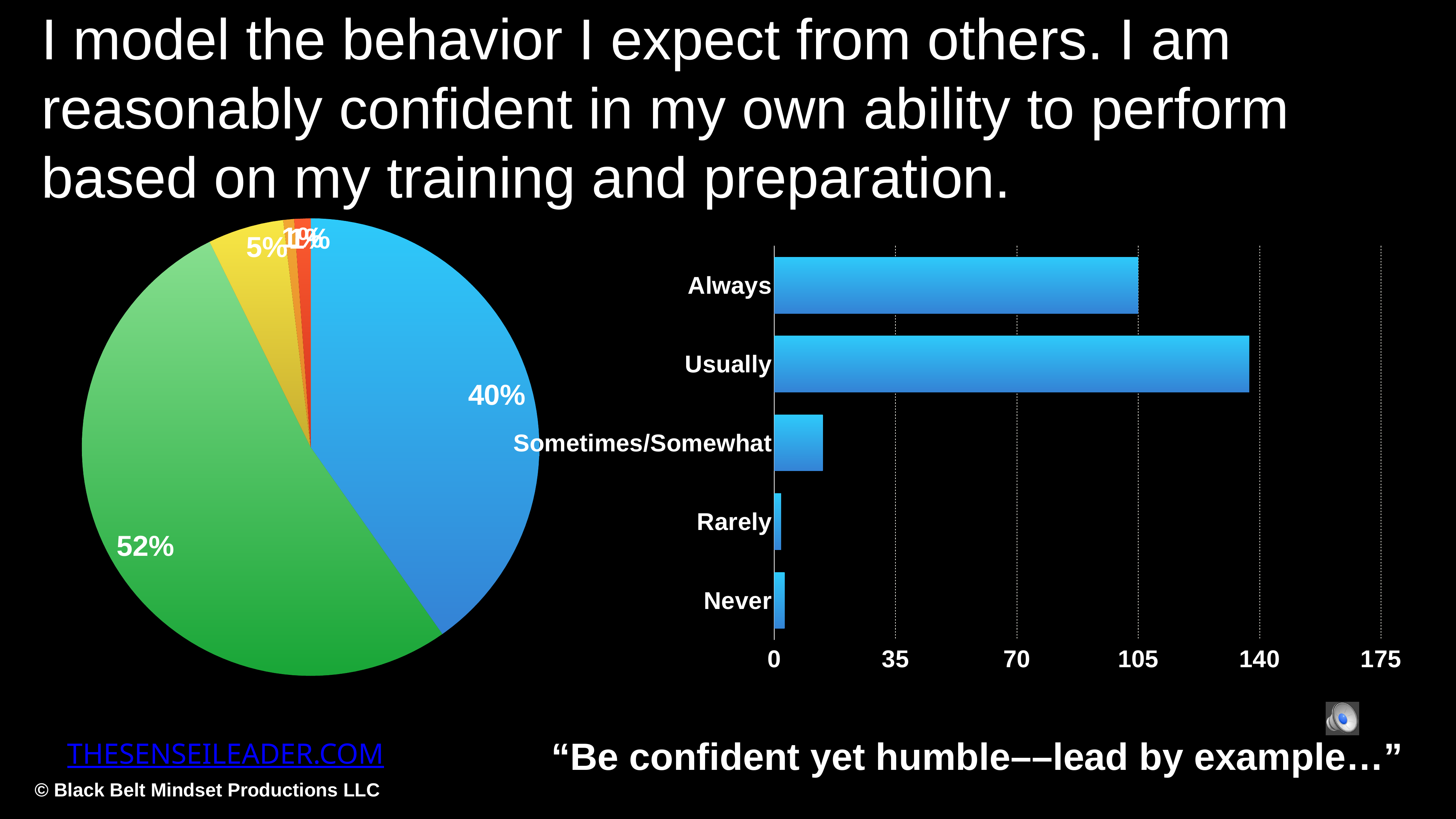
In the pie chart on the left, what is the difference in percentage points between the green slice and the blue slice? 12 In the bar chart on the right, how many categories are shown? 5 In the bar chart on the right, which is larger, the value for Always or the value for Usually? Usually In the bar chart on the right, is the value for Always greater or less than 70? greater In the bar chart on the right, which category has the highest value? Usually In the pie chart on the left, what percentage is shown on the blue slice? 40% In the bar chart on the right, is the value for Sometimes/Somewhat greater or less than 35? less What kind of chart is the chart on the left side of the slide? pie chart In the bar chart on the right, is the value for Usually greater or less than 105? greater What kind of chart is the chart on the right side of the slide? bar chart In the pie chart on the left, what percentage is shown on the green slice? 52%